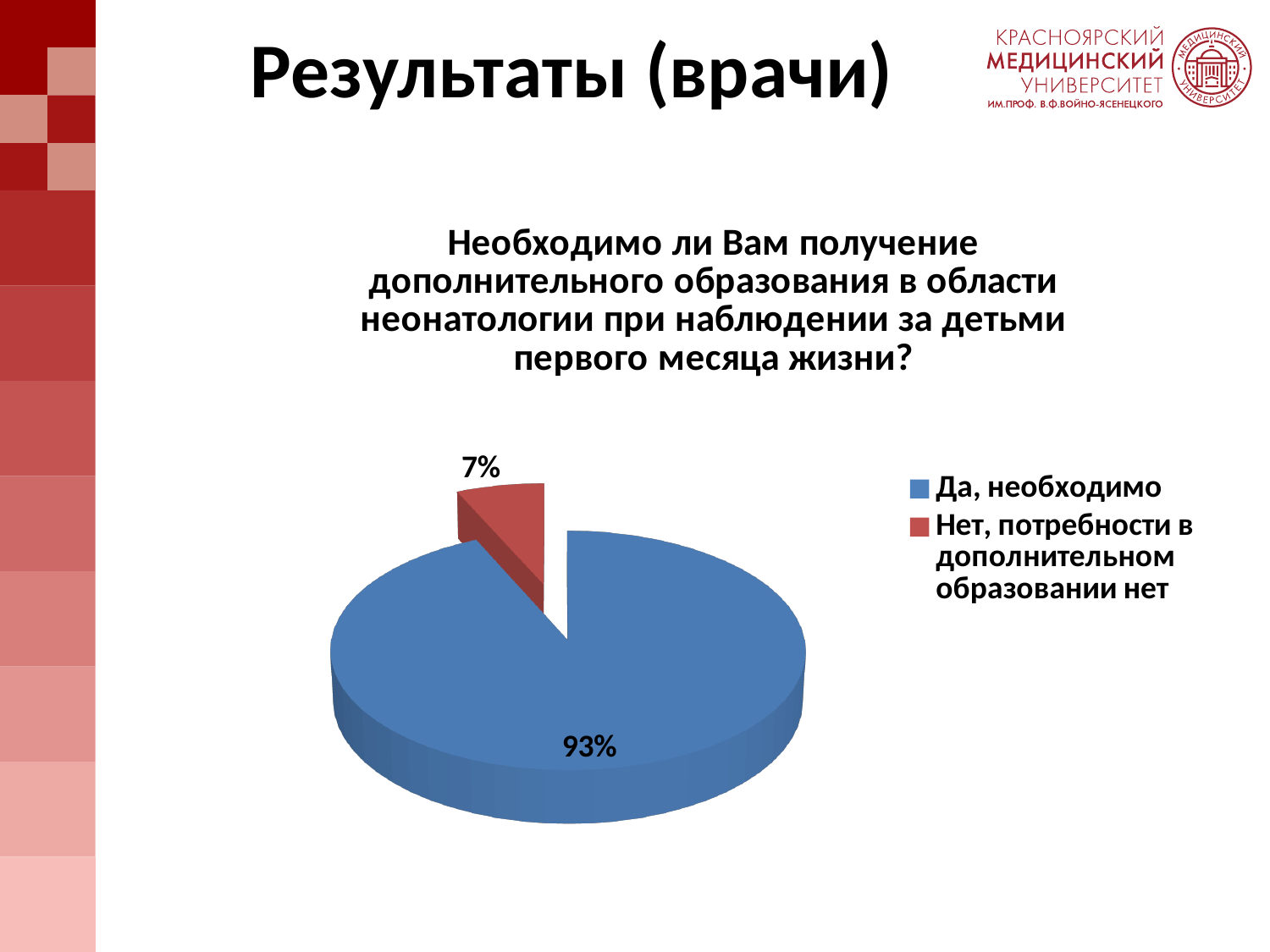
Which category has the largest slice of the pie? Да, необходимо Which is larger: the share for "Да, необходимо" or the share for "Нет, потребности в дополнительном образовании нет"? Да, необходимо What colour is the slice for "Да, необходимо"? blue How many slices does the pie chart have? 2 What kind of chart is shown on the slide? pie chart What share of the pie is labelled "Нет, потребности в дополнительном образовании нет"? 7% What is the difference in percentage points between the "Да, необходимо" slice and the "Нет, потребности в дополнительном образовании нет" slice? 86 How many entries does the legend list? 2 What share of the pie is labelled "Да, необходимо"? 93% Which category has the smallest slice of the pie? Нет, потребности в дополнительном образовании нет What colour is the slice for "Нет, потребности в дополнительном образовании нет"? red